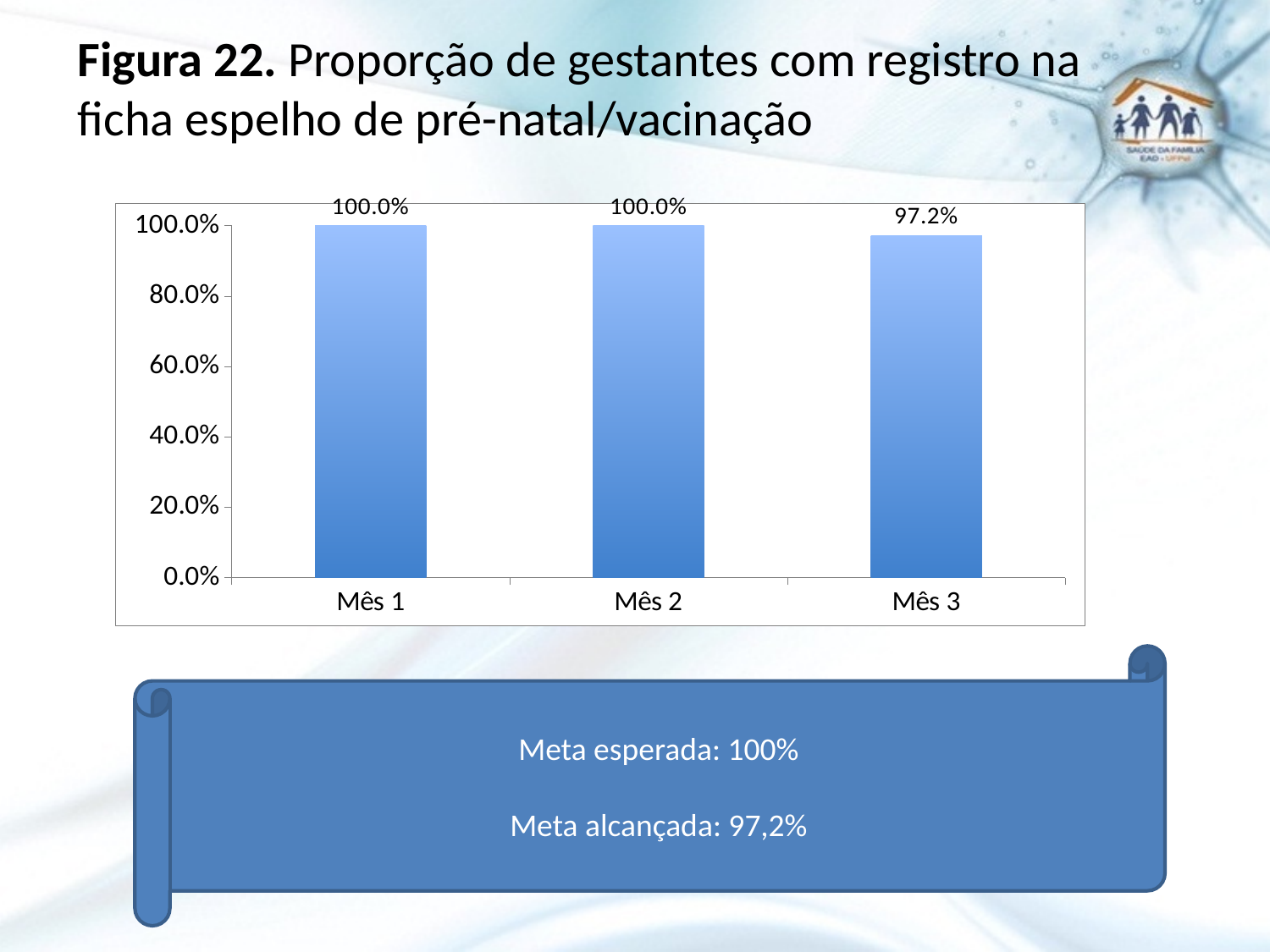
Is the value for Mês 3 greater or less than 80.0%? greater What is the figure number given in the slide title? Figura 22 What kind of chart is shown on the slide? bar chart What is the highest value shown on the y axis? 100.0% How many categories are shown on the x axis? 3 Which month has the lowest value? Mês 3 Which is larger, the value for Mês 2 or the value for Mês 3? Mês 2 What is the value for Mês 3? 97.2% Do the values rise, fall or stay the same from Mês 2 to Mês 3? fall What is the value for Mês 2? 100.0% What is the value for Mês 1? 100.0% What is the difference between the values for Mês 1 and Mês 3? 2.8%